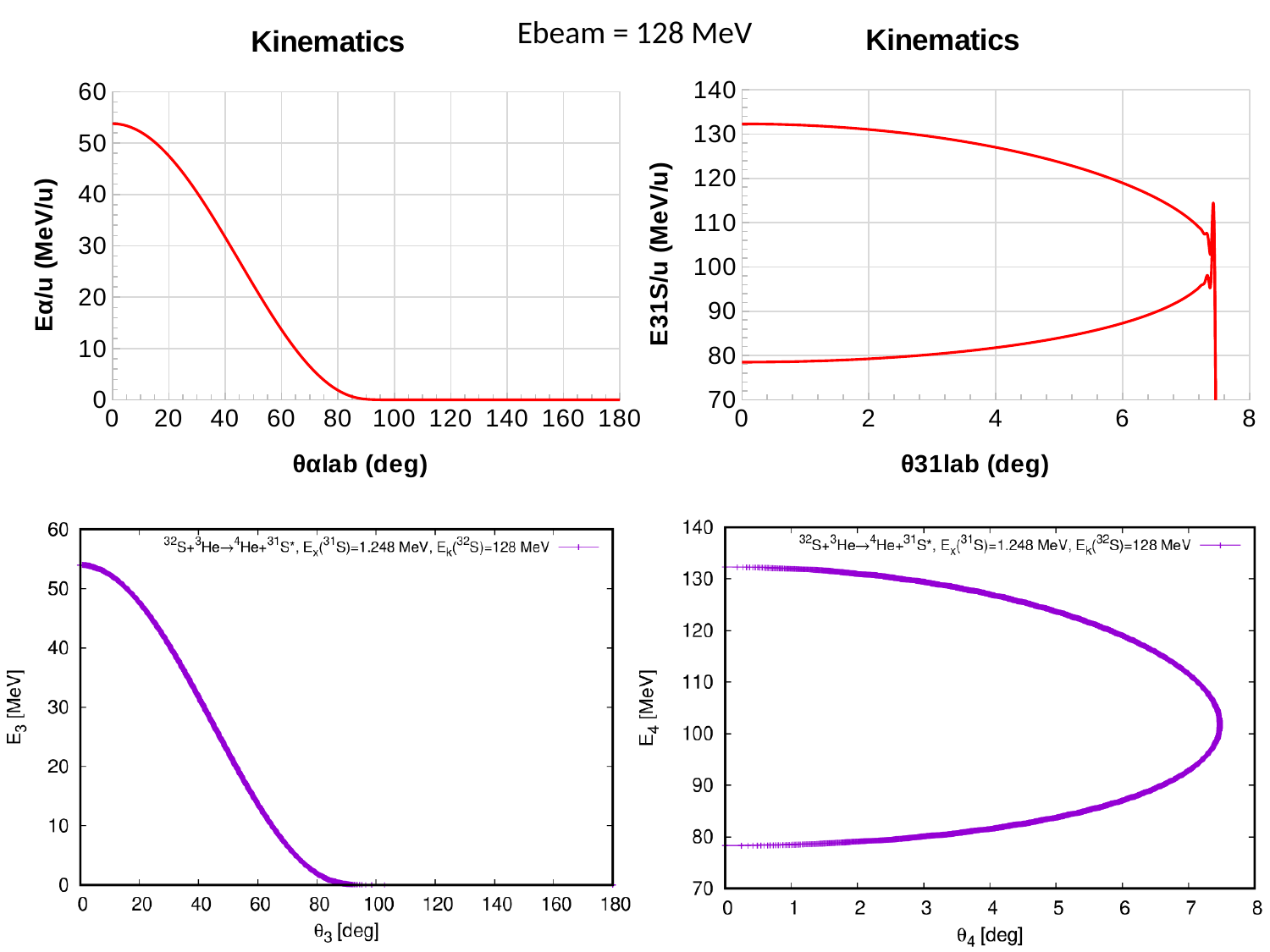
What is the x-axis label of the top-right chart titled Kinematics? θ31lab (deg) In the bottom-left chart (E3 vs θ3), is the value at θ3 = 40 degrees greater or less than 20 MeV? greater In the bottom-right chart (E4 vs θ4), is the maximum θ4 reached by the curve greater or less than 7 degrees? greater In the top-right chart (E31S/u vs θ31lab), is the lower branch value at θ31lab = 0 degrees greater or less than 80 MeV/u? less In the top-right chart (E31S/u vs θ31lab), does the upper branch rise or fall as θ31lab increases from 0 to 7 degrees? Fall How many charts are shown on the slide? 4 In the top-left chart (Eα/u vs θαlab), does the value rise or fall as θαlab increases from 0 to 90 degrees? Fall What kind of chart is the top-left chart titled Kinematics? Line chart What is the y-axis label of the bottom-left chart? E3 [MeV]